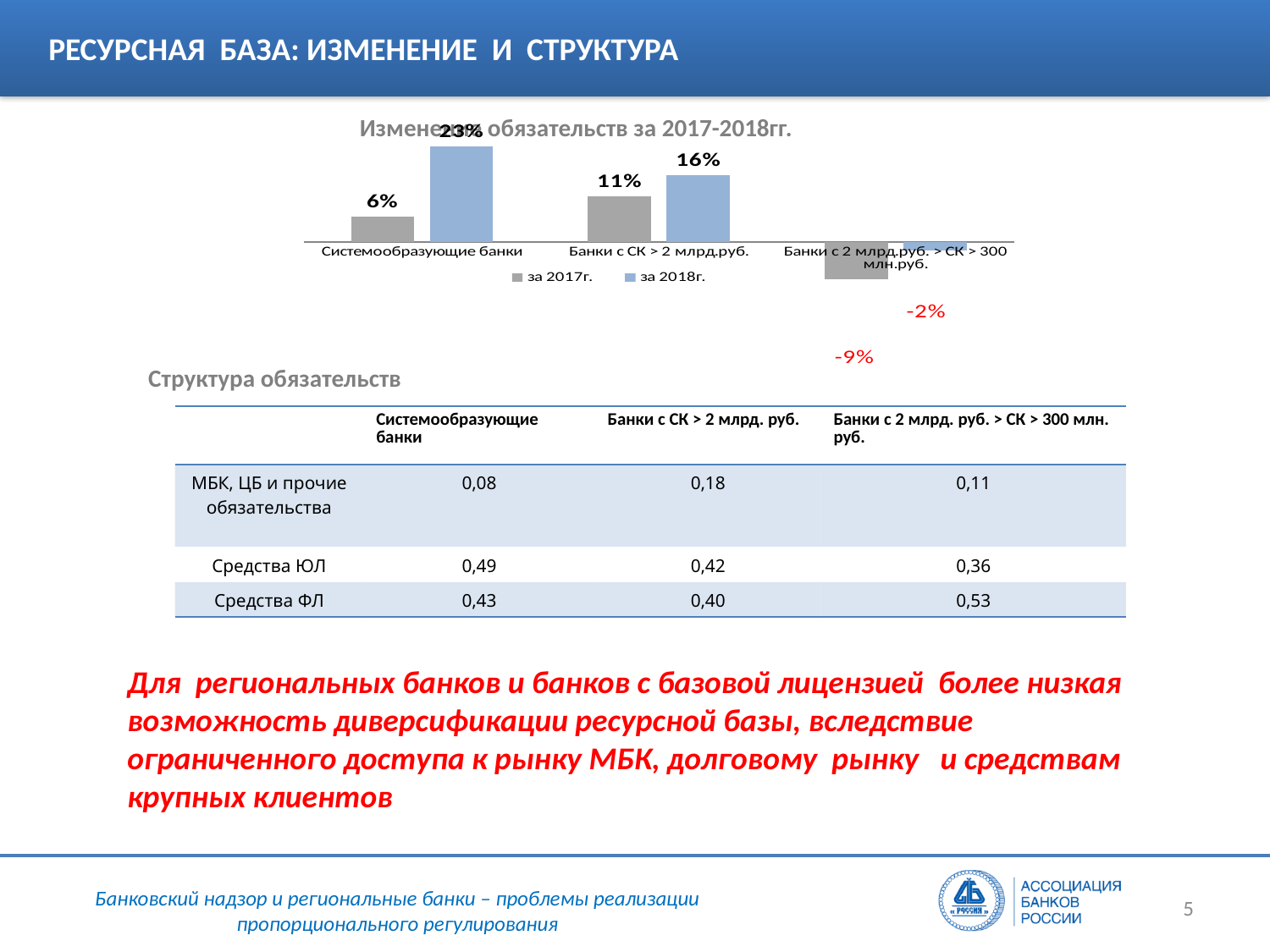
In the chart 'Изменение обязательств за 2017-2018гг.', what is the value for Банки с СК > 2 млрд.руб. за 2017г.? 11% In the chart 'Изменение обязательств за 2017-2018гг.', by how many percentage points does the 2018 value for Системообразующие банки exceed the 2017 value? 17 percentage points In the chart 'Изменение обязательств за 2017-2018гг.', what is the value for Системообразующие банки за 2018г.? 23% How many series does the legend of the chart 'Изменение обязательств за 2017-2018гг.' list? 2 In the chart 'Изменение обязательств за 2017-2018гг.', what is the difference between the 2018 and 2017 values for Банки с СК > 2 млрд.руб.? 5 percentage points What kind of chart is 'Изменение обязательств за 2017-2018гг.'? Bar chart In the chart 'Изменение обязательств за 2017-2018гг.', what is the value for Системообразующие банки за 2017г.? 6% In the chart 'Изменение обязательств за 2017-2018гг.', which category has the highest value за 2018г.? Системообразующие банки In the chart 'Изменение обязательств за 2017-2018гг.', what is the value for Банки с СК > 2 млрд.руб. за 2018г.? 16% In the chart 'Изменение обязательств за 2017-2018гг.', which category has the lowest value за 2017г.? Банки с 2 млрд.руб. > СК > 300 млн.руб. In the chart 'Изменение обязательств за 2017-2018гг.', which is larger за 2017г.: Системообразующие банки or Банки с СК > 2 млрд.руб.? Банки с СК > 2 млрд.руб. How many categories are shown on the x axis of the chart 'Изменение обязательств за 2017-2018гг.'? 3